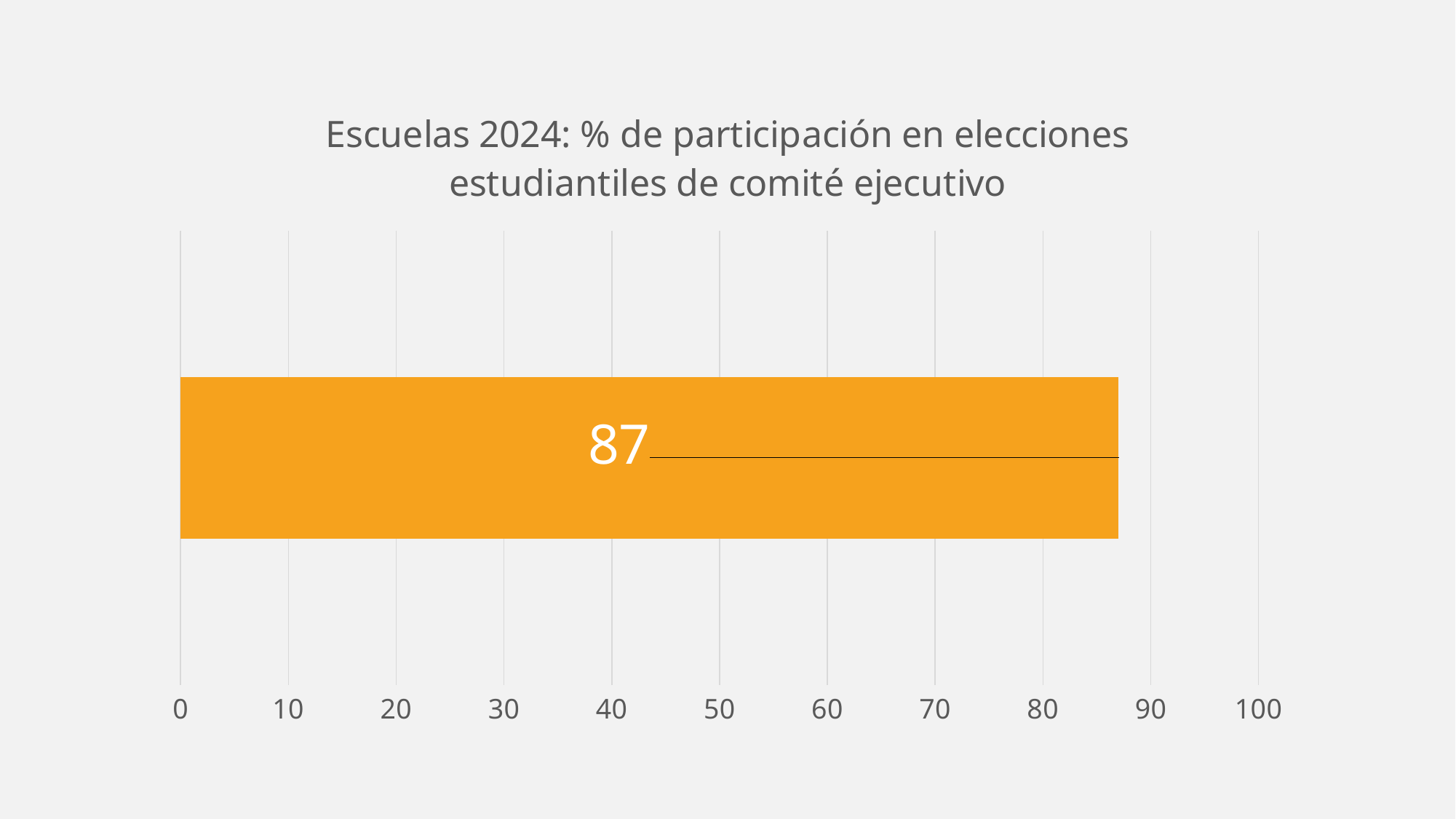
What is the highest tick value shown on the horizontal axis? 100 Is the value of the bar greater or less than 90? less What value is printed on the bar in the chart? 87 What kind of chart is shown on the slide? bar chart Is the value of the bar greater or less than 50? greater What is the title of the chart? Escuelas 2024: % de participación en elecciones estudiantiles de comité ejecutivo How many bars are plotted in the chart? 1 Is the value of the bar greater or less than 80? greater What colour is the bar in the chart? orange